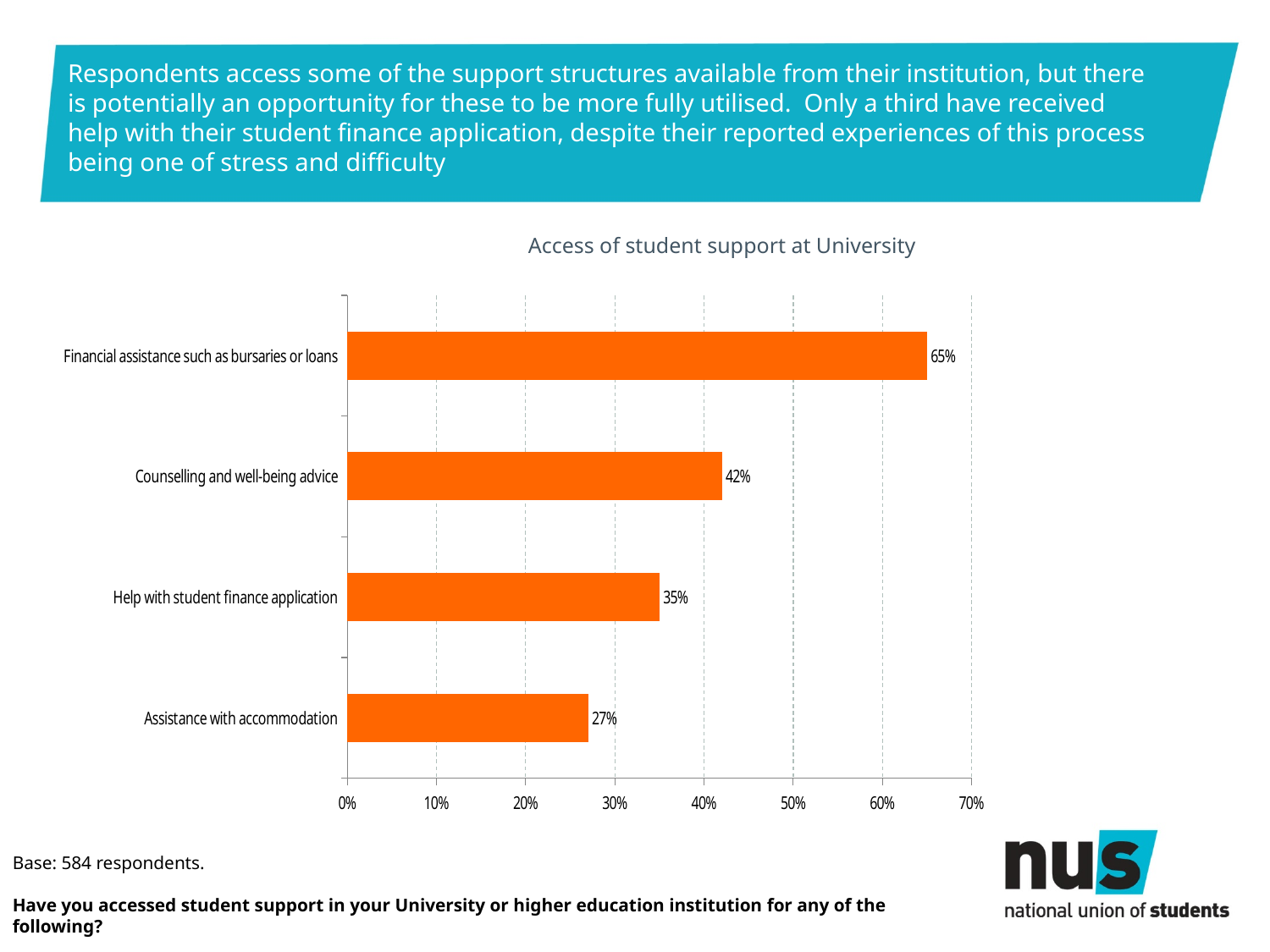
Which type of student support was accessed by the highest share of respondents? Financial assistance such as bursaries or loans Which type of student support was accessed by the lowest share of respondents? Assistance with accommodation What percentage of respondents received help with their student finance application? 35% What percentage of respondents accessed financial assistance such as bursaries or loans? 65% Which is larger: the value for Counselling and well-being advice or the value for Help with student finance application? Counselling and well-being advice Is the value for Help with student finance application greater or less than 30%? greater What is the value for Counselling and well-being advice? 42% What is the value for Assistance with accommodation? 27% How many categories of student support are shown in the chart? 4 What type of chart is used to show access of student support at University? Bar chart What is the difference between Counselling and well-being advice and Help with student finance application? 7 percentage points What is the difference in percentage points between Financial assistance such as bursaries or loans and Assistance with accommodation? 38 percentage points